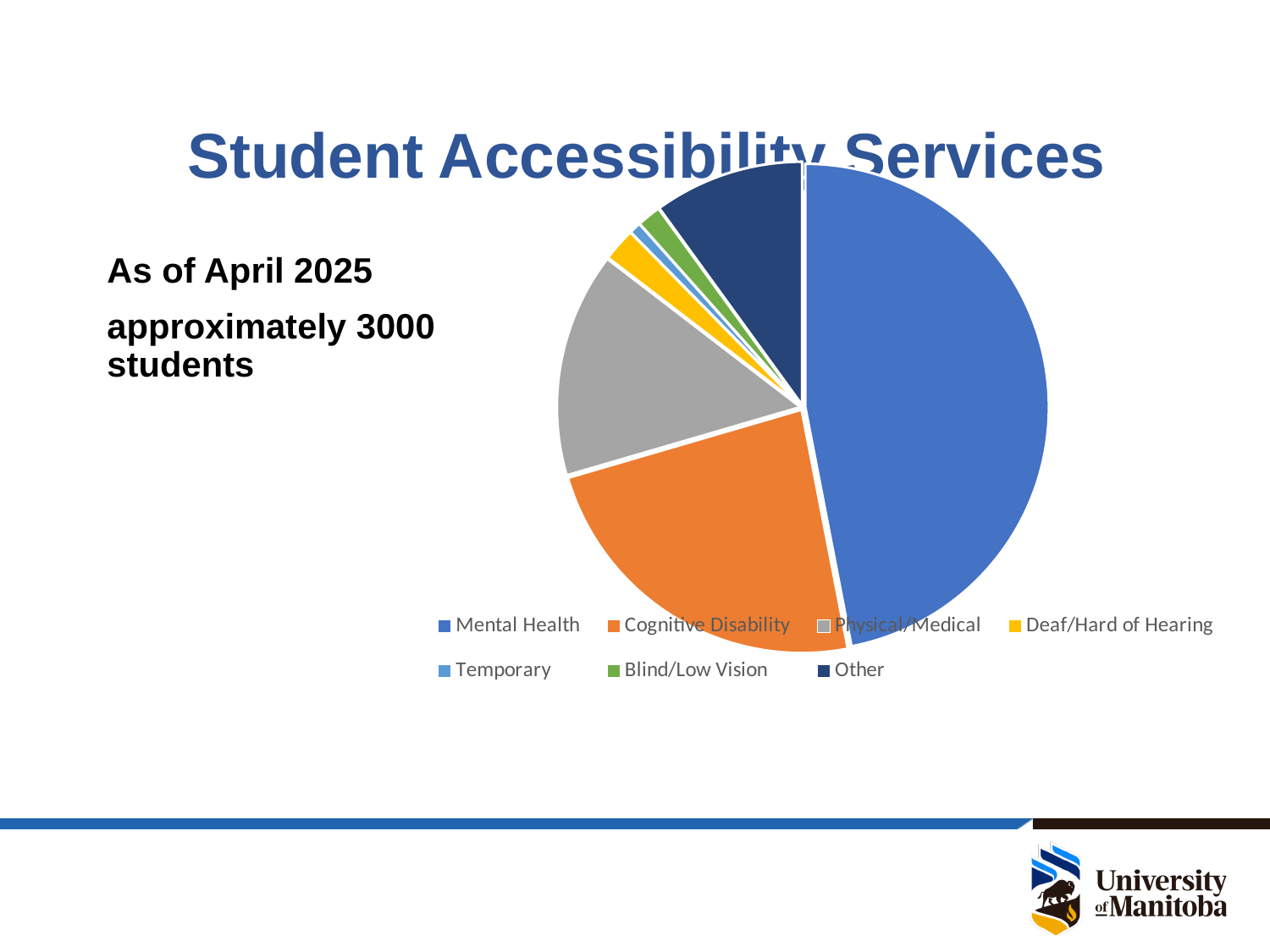
Which slice is larger, Physical/Medical or Other? Physical/Medical Which slice is larger, Cognitive Disability or Physical/Medical? Cognitive Disability How many categories does the pie chart show? 7 Which slice is larger, Other or Deaf/Hard of Hearing? Other What kind of chart is shown on the slide? pie chart What colour is the Cognitive Disability slice in the pie chart? orange Which category has the second-largest slice of the pie chart? Cognitive Disability Which category is shown in yellow in the legend? Deaf/Hard of Hearing Which category has the largest slice of the pie chart? Mental Health